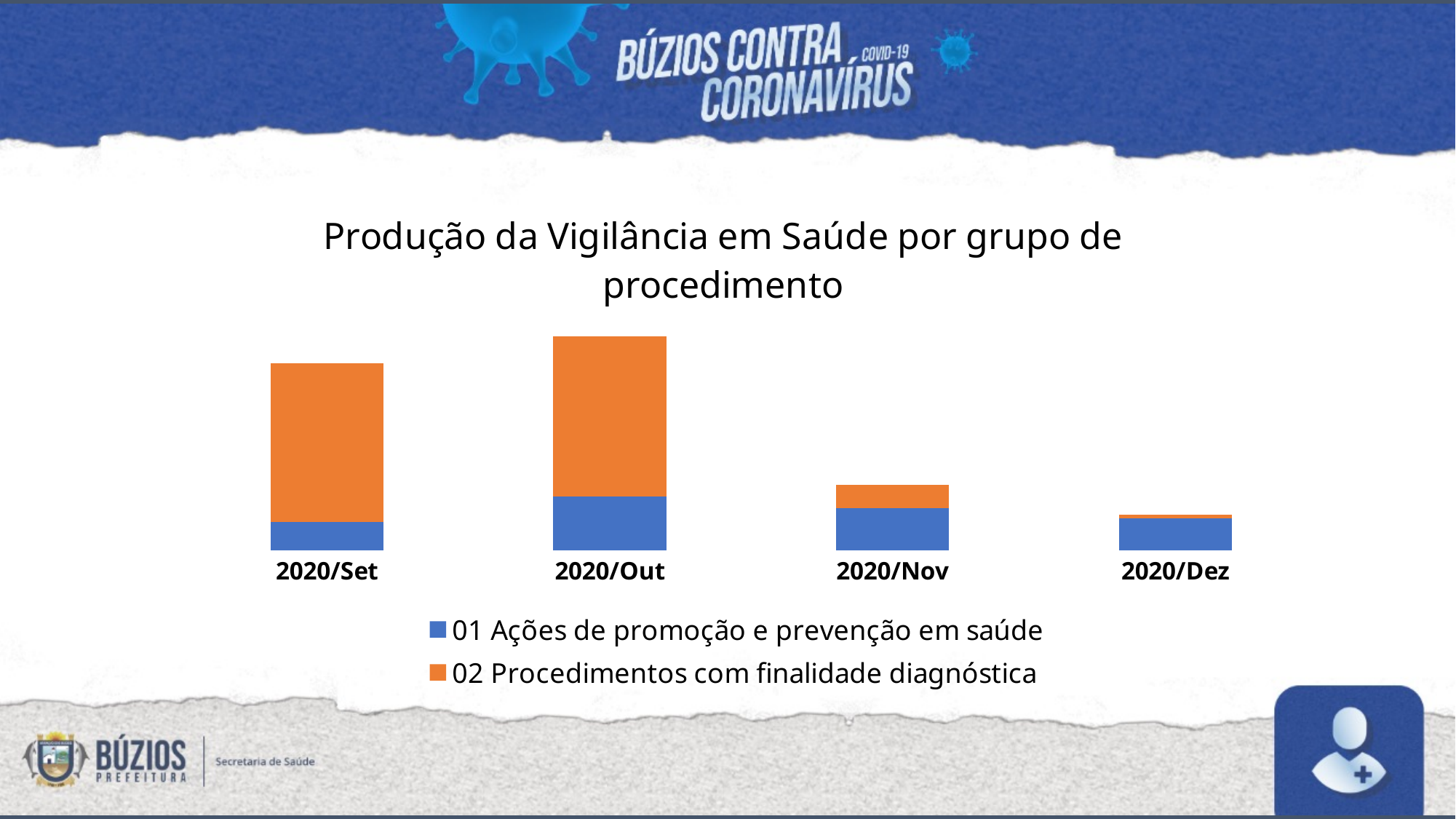
From 2020/Out to 2020/Dez, do the total bar heights rise or fall? Fall Is the total bar for 2020/Set larger or smaller than the total bar for 2020/Nov? Larger What kind of chart is shown on the slide? Stacked bar chart What is the title of the chart? Produção da Vigilância em Saúde por grupo de procedimento How many months (categories) are shown on the x axis of the chart? 4 Which month has the tallest stacked bar overall? 2020/Out Which month has the smallest orange segment (02 Procedimentos com finalidade diagnóstica)? 2020/Dez In 2020/Set, which series has the larger segment: 01 Ações de promoção e prevenção em saúde or 02 Procedimentos com finalidade diagnóstica? 02 Procedimentos com finalidade diagnóstica Which month has the shortest stacked bar overall? 2020/Dez Which month has the largest blue segment (01 Ações de promoção e prevenção em saúde)? 2020/Out How many series does the chart legend list? 2